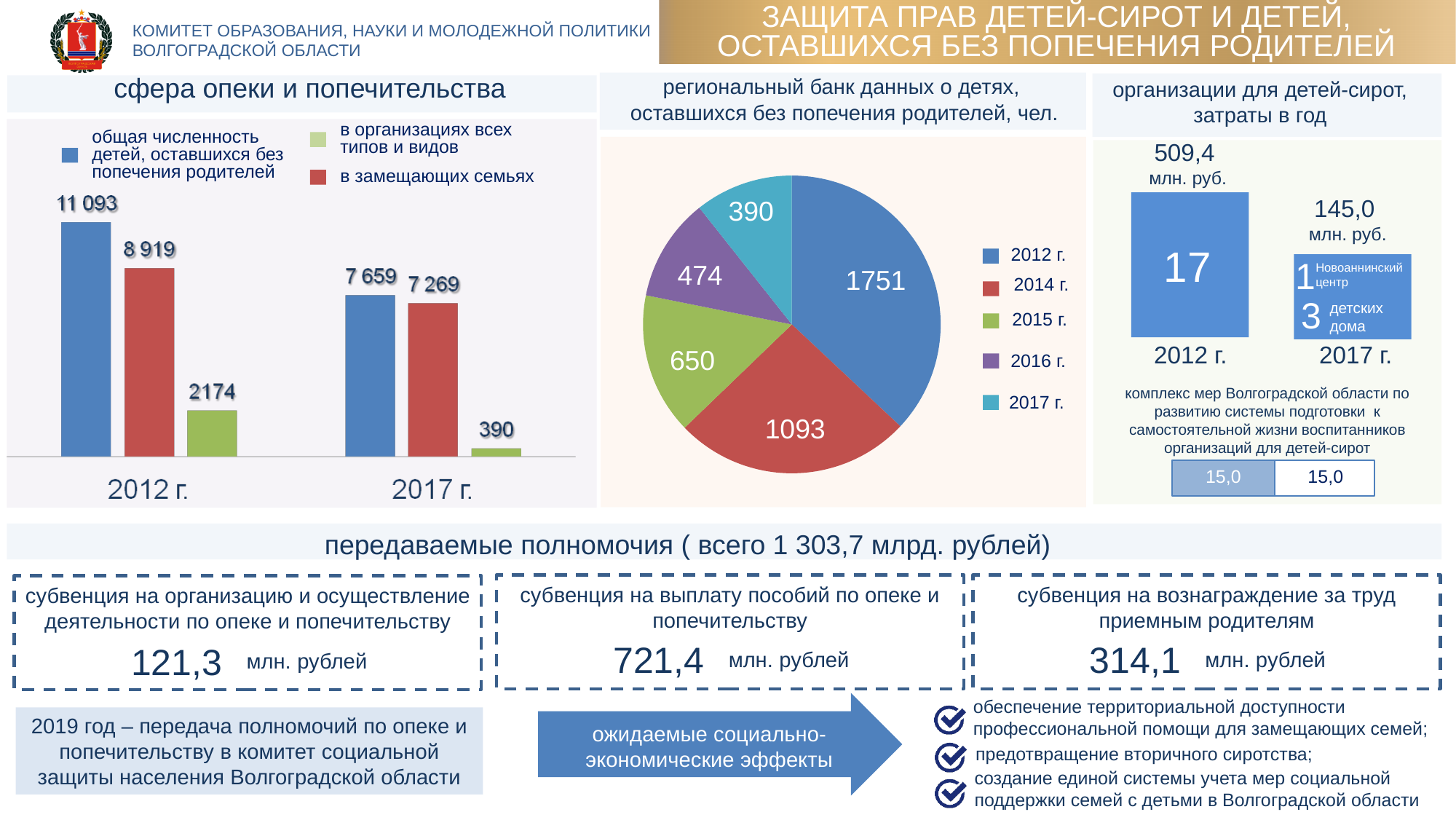
In the bar chart titled 'сфера опеки и попечительства', does the value for 'в организациях всех типов и видов' rise or fall from 2012 г. to 2017 г.? fall In the pie chart titled 'региональный банк данных о детях, оставшихся без попечения родителей, чел.', which year has the largest slice? 2012 г. In the bar chart titled 'сфера опеки и попечительства', what is the value for 'общая численность детей, оставшихся без попечения родителей' in 2012 г.? 11 093 In the bar chart titled 'сфера опеки и попечительства', what is the value for 'в замещающих семьях' in 2012 г.? 8 919 In the pie chart titled 'региональный банк данных о детях, оставшихся без попечения родителей, чел.', how many slices are there? 5 What kind of chart is the one titled 'сфера опеки и попечительства'? bar chart In the pie chart titled 'региональный банк данных о детях, оставшихся без попечения родителей, чел.', what is the value for 2015 г.? 650 In the bar chart titled 'сфера опеки и попечительства', what is the value for 'в организациях всех типов и видов' in 2017 г.? 390 In the bar chart titled 'сфера опеки и попечительства', which is larger: 'в организациях всех типов и видов' in 2012 г. or in 2017 г.? 2012 г. In the bar chart titled 'сфера опеки и попечительства', what is the difference between the 'общая численность детей, оставшихся без попечения родителей' values for 2012 г. and 2017 г.? 3 434 In the pie chart titled 'региональный банк данных о детях, оставшихся без попечения родителей, чел.', which year has the smallest slice? 2017 г. In the bar chart titled 'сфера опеки и попечительства', how many series does the legend list? 3